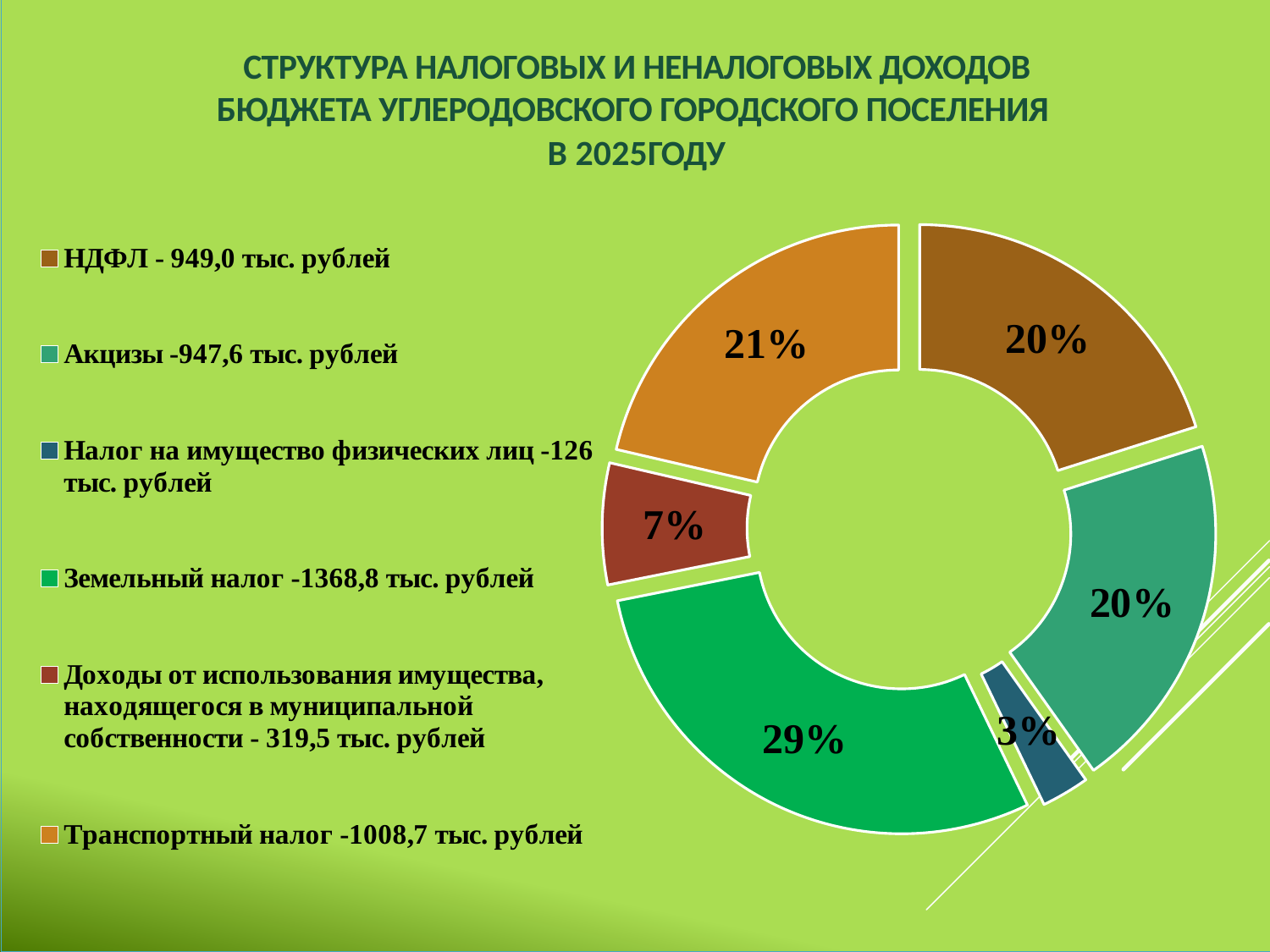
What is the value for Доходы от использования имущества, находящегося в муниципальной собственности given in the legend? 319,5 тыс. рублей Which category has the smallest share of the chart? Налог на имущество физических лиц What is the difference in тыс. рублей between Земельный налог and Транспортный налог? 360,1 тыс. рублей How many categories are shown in the chart? 6 What is the value for Транспортный налог given in the legend? 1008,7 тыс. рублей Which category has the largest share of the chart? Земельный налог What percentage is shown for Транспортный налог? 21% What percentage is shown for Налог на имущество физических лиц? 3% By how many percentage points does the share of Земельный налог exceed the share of Транспортный налог? 8% What is the value for Акцизы given in the legend? 947,6 тыс. рублей What kind of chart is shown on the slide? Pie chart (doughnut) What share of the chart does Земельный налог account for? 29%